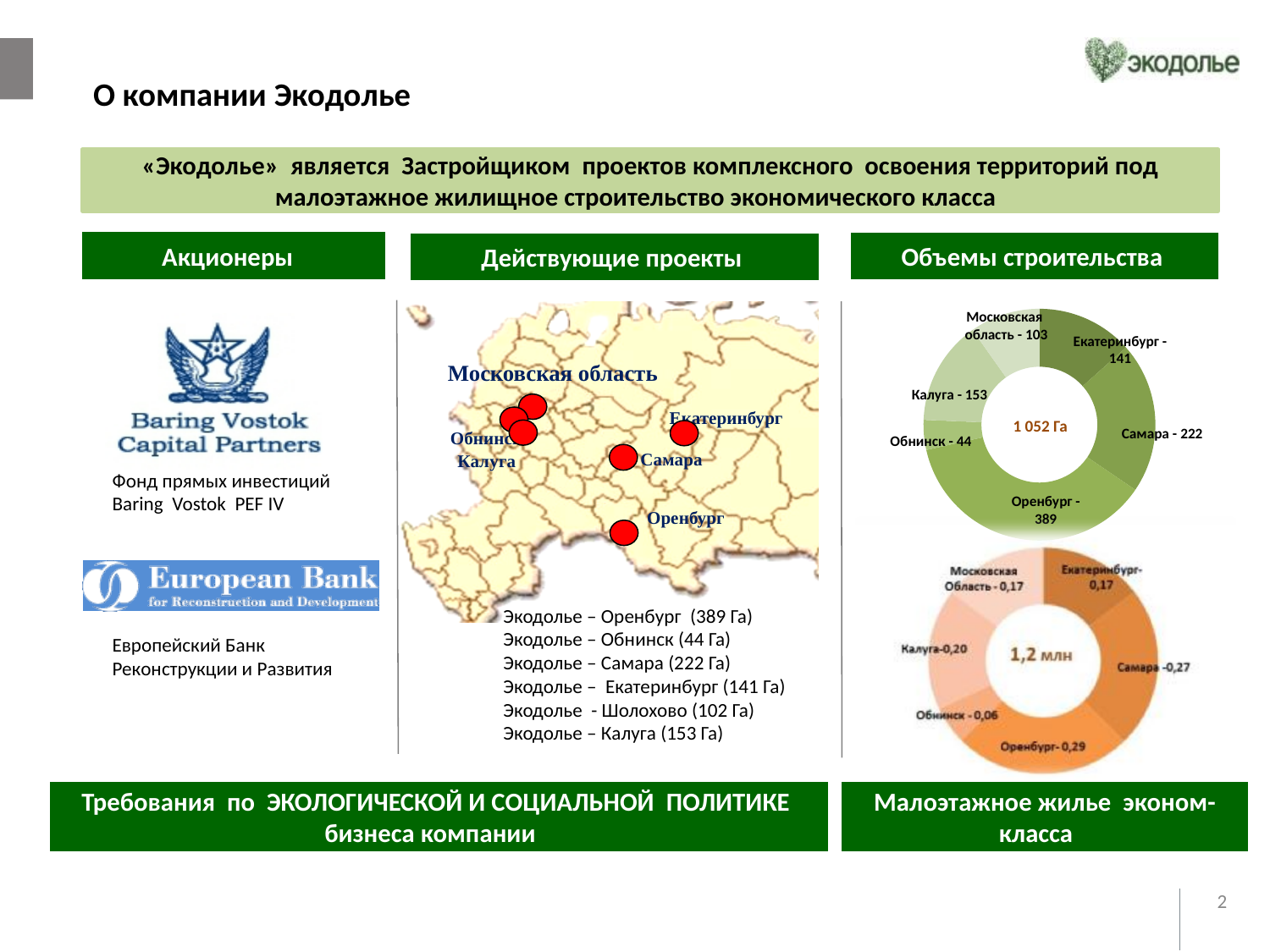
On the upper (green) donut chart, what is the value for Самара? 222 How many categories does the upper (green) donut chart show? 6 On the upper (green) donut chart, which is larger: Калуга or Екатеринбург? Калуга On the lower (orange) donut chart, what is the value for Обнинск? 0,06 On the lower (orange) donut chart, what is the value for Самара? 0,27 On the upper (green) donut chart, which category has the smallest value? Обнинск What type of chart is used in the Объемы строительства section? Donut (pie) chart On the upper (green) donut chart, what is the difference between the values for Оренбург and Самара? 167 On the upper (green) donut chart, what is the value for Оренбург? 389 On the lower (orange) donut chart, which category has the largest value? Оренбург On the upper (green) donut chart, what total is shown in the centre? 1 052 Га On the upper (green) donut chart, which category has the largest value? Оренбург